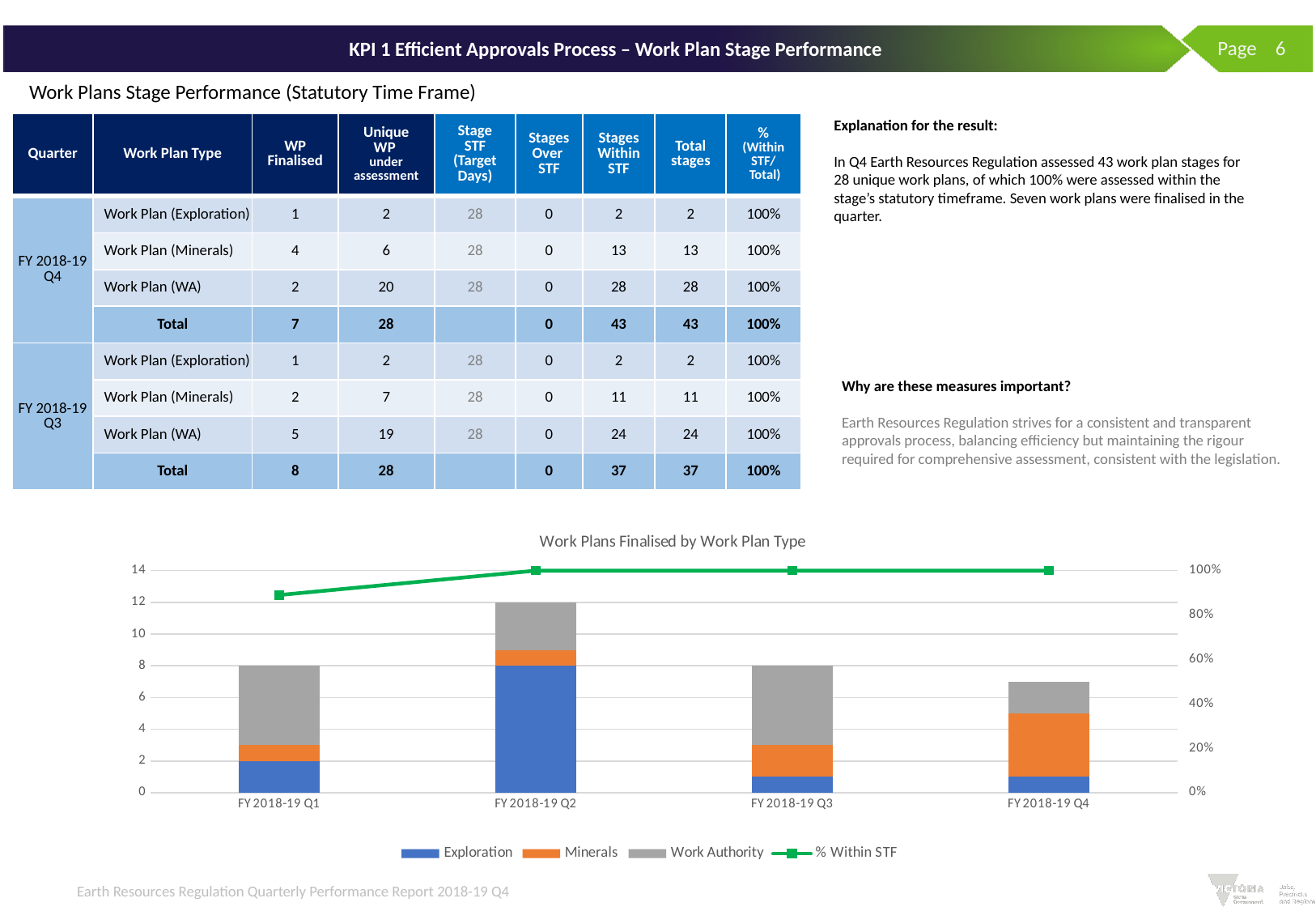
In the 'Work Plans Finalised by Work Plan Type' chart, which quarter has the shortest stacked bar? FY 2018-19 Q4 In the 'Work Plans Finalised by Work Plan Type' chart, what is the % Within STF value for FY 2018-19 Q4? 100% What kind of chart is 'Work Plans Finalised by Work Plan Type'? bar chart with a line In the 'Work Plans Finalised by Work Plan Type' chart, which quarter has the tallest stacked bar? FY 2018-19 Q2 In the 'Work Plans Finalised by Work Plan Type' chart, what is the total height of the stacked bar for FY 2018-19 Q2? 12 How many quarters are shown on the x axis of the 'Work Plans Finalised by Work Plan Type' chart? 4 In the 'Work Plans Finalised by Work Plan Type' chart, is the total stacked bar for FY 2018-19 Q4 greater or less than 8? less How many series does the legend of the 'Work Plans Finalised by Work Plan Type' chart list? 4 In the 'Work Plans Finalised by Work Plan Type' chart, does the % Within STF line rise or fall from FY 2018-19 Q1 to FY 2018-19 Q2? rise In the 'Work Plans Finalised by Work Plan Type' chart, is the Exploration segment larger in FY 2018-19 Q1 or FY 2018-19 Q2? FY 2018-19 Q2 In the 'Work Plans Finalised by Work Plan Type' chart, is the % Within STF value for FY 2018-19 Q1 greater or less than 80%? greater In the 'Work Plans Finalised by Work Plan Type' chart, what is the total height of the stacked bar for FY 2018-19 Q1? 8